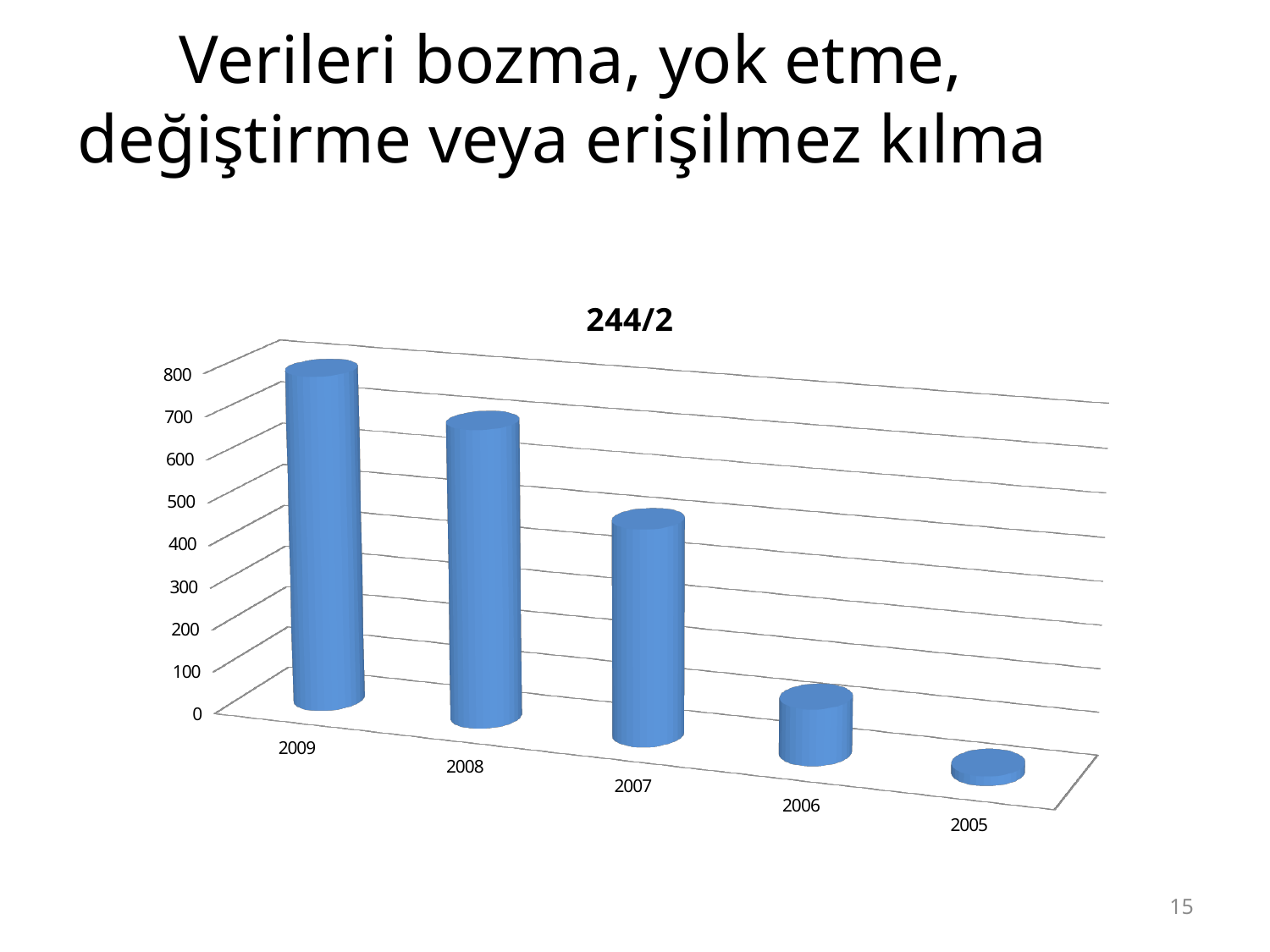
Do the values rise or fall moving from 2009 to 2005 along the x axis? fall Which year has the highest bar in the chart? 2009 What kind of chart is shown on the slide? bar chart Is the value for 2006 greater or less than 300? less Is the value for 2007 greater or less than 300? greater Is the value for 2008 greater or less than 500? greater Which year has the larger value, 2008 or 2007? 2008 What is the title of the chart? 244/2 Which year has the lowest bar in the chart? 2005 How many years are shown on the x axis of the chart? 5 Which year has the larger value, 2006 or 2005? 2006